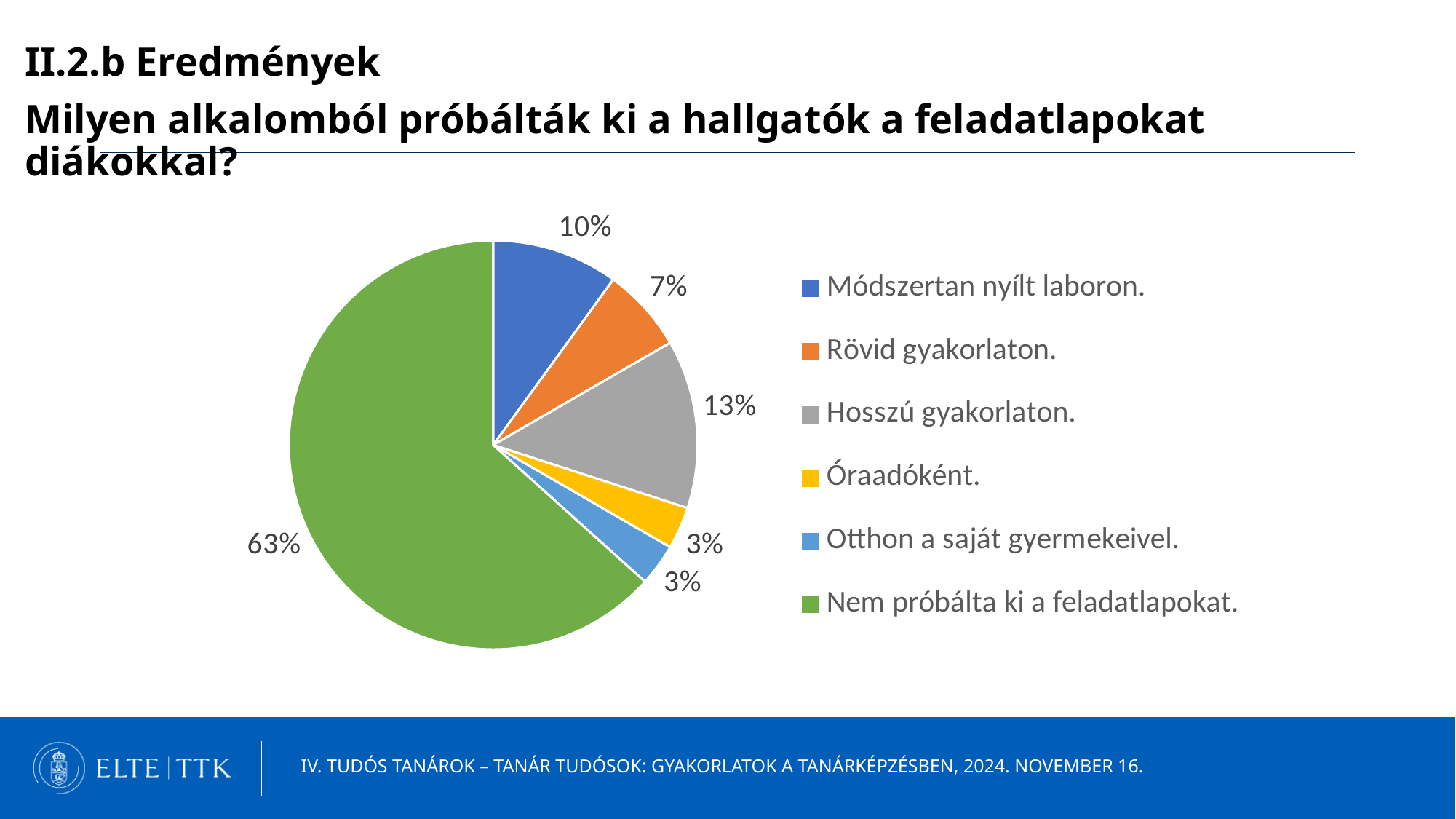
Which category has the largest slice of the pie? Nem próbálta ki a feladatlapokat. How many entries does the legend list? 6 What is the value for "Hosszú gyakorlaton."? 13% What is the value for "Óraadóként."? 3% Which is larger, the slice for "Hosszú gyakorlaton." or the slice for "Módszertan nyílt laboron."? Hosszú gyakorlaton. What share of the pie does "Nem próbálta ki a feladatlapokat." take? 63% Which colour represents "Óraadóként." in the legend? yellow What kind of chart is shown on the slide? pie chart What is the difference between the values for "Hosszú gyakorlaton." and "Rövid gyakorlaton."? 6% What is the value for "Módszertan nyílt laboron."? 10% What is the value for "Rövid gyakorlaton."? 7% How many slices does the pie chart have? 6